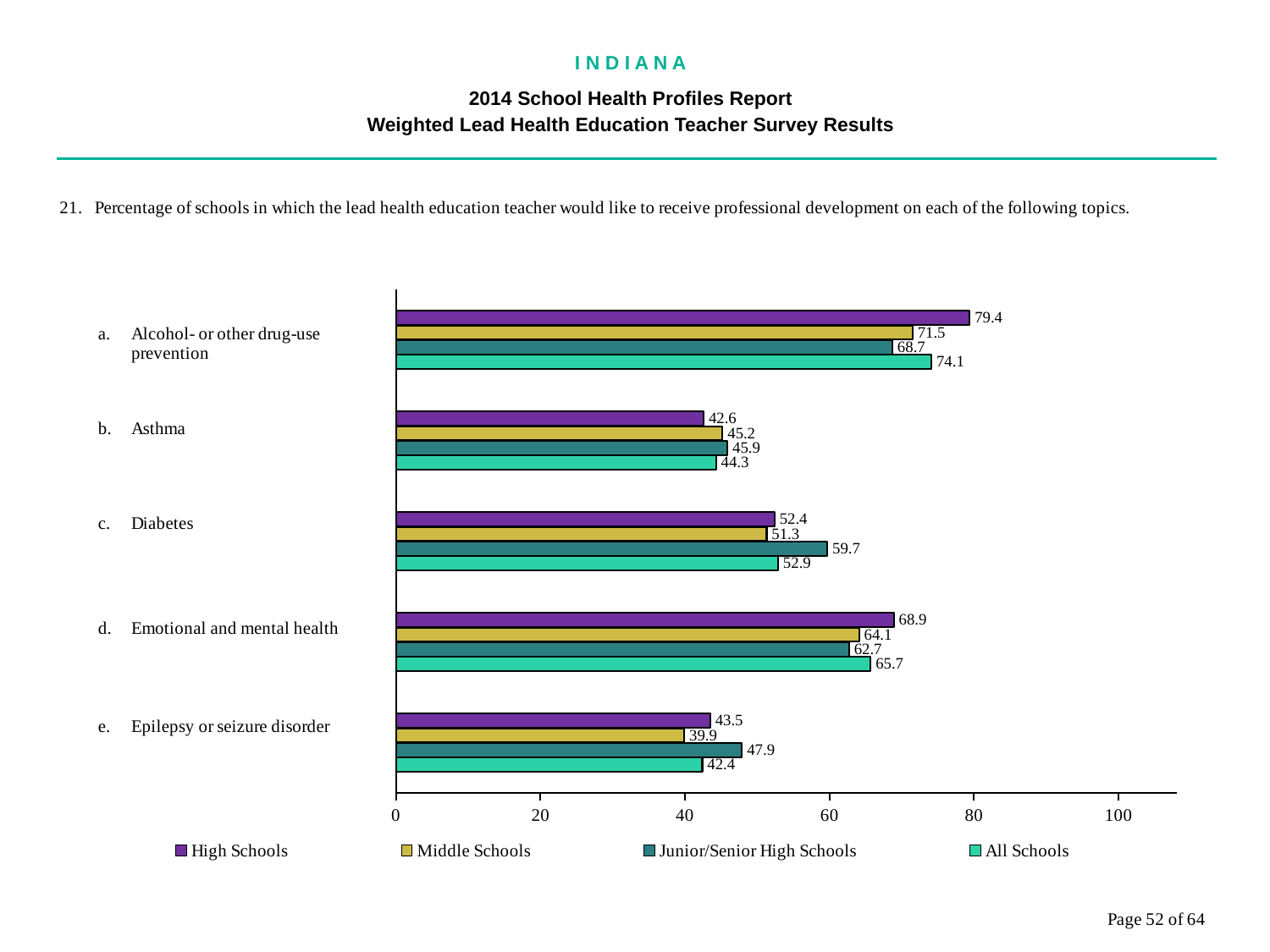
How many series does the legend list? 4 Which topic has the highest value for High Schools? Alcohol- or other drug-use prevention Is the All Schools value for Diabetes greater or less than 60? less What is the value for Junior/Senior High Schools for Diabetes? 59.7 What is the value for All Schools for Emotional and mental health? 65.7 Which is larger for Asthma: the High Schools value or the Junior/Senior High Schools value? Junior/Senior High Schools Which topic has the lowest value for Middle Schools? Epilepsy or seizure disorder How many topics are shown on the chart? 5 What is the value for High Schools for Alcohol- or other drug-use prevention? 79.4 What kind of chart is shown on the slide? bar chart What is the value for Middle Schools for Epilepsy or seizure disorder? 39.9 What is the difference between the High Schools and Middle Schools values for Alcohol- or other drug-use prevention? 7.9